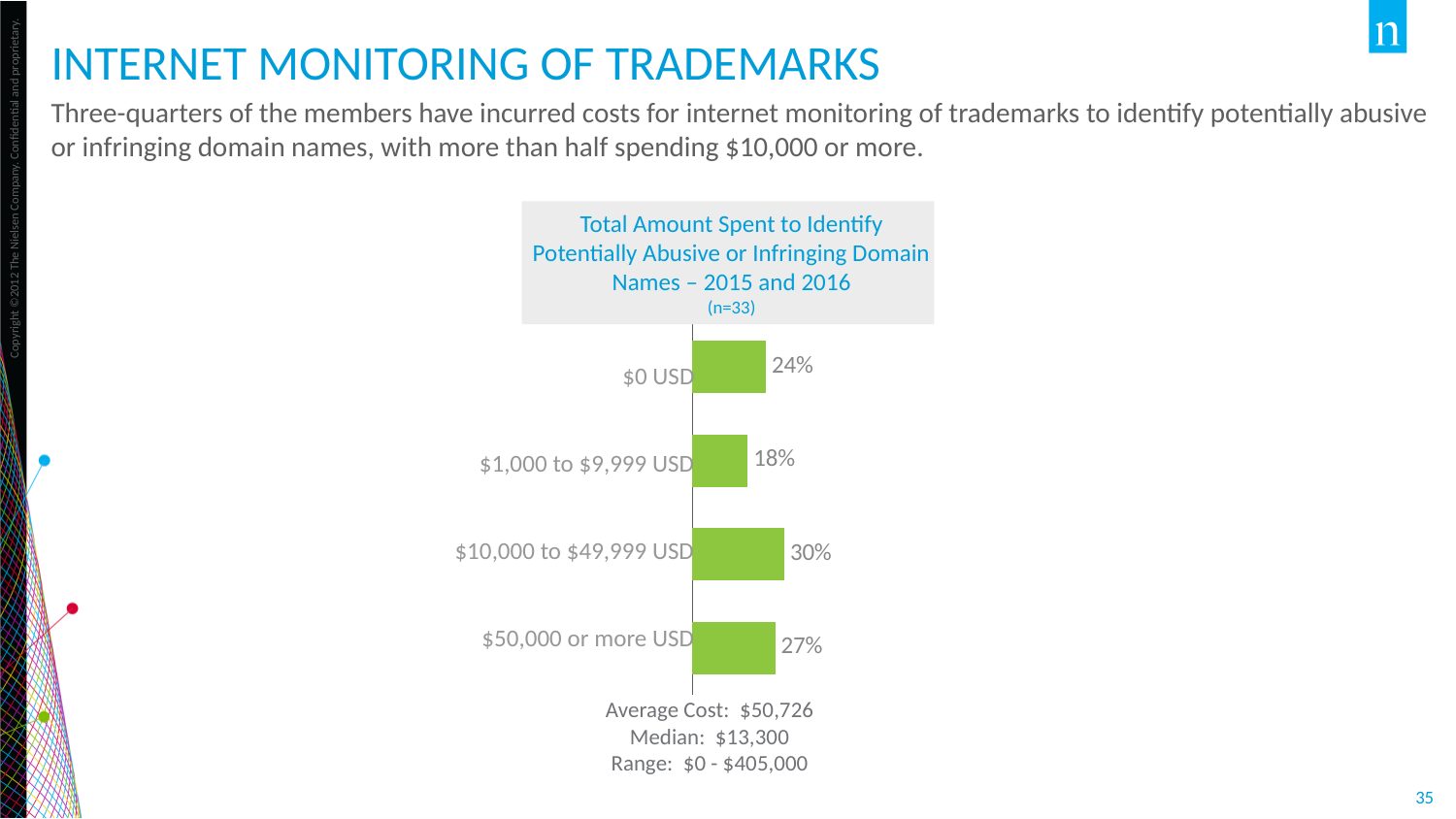
Which spending category has the lowest percentage of members? $1,000 to $9,999 USD How many spending categories are shown in the chart? 4 What is the median cost shown below the chart? $13,300 Which spending category has the highest percentage of members? $10,000 to $49,999 USD What is the sample size (n) shown in the chart title? n=33 What type of chart is used to show the total amount spent? Bar chart What percentage of members spent $0 USD on identifying potentially abusive or infringing domain names? 24% What percentage of members spent $1,000 to $9,999 USD? 18% Which category has a larger share of members: $0 USD or $50,000 or more USD? $50,000 or more USD What percentage of members spent $50,000 or more USD? 27% What percentage of members spent $10,000 to $49,999 USD? 30% What is the difference in percentage points between the $10,000 to $49,999 USD category and the $1,000 to $9,999 USD category? 12 percentage points